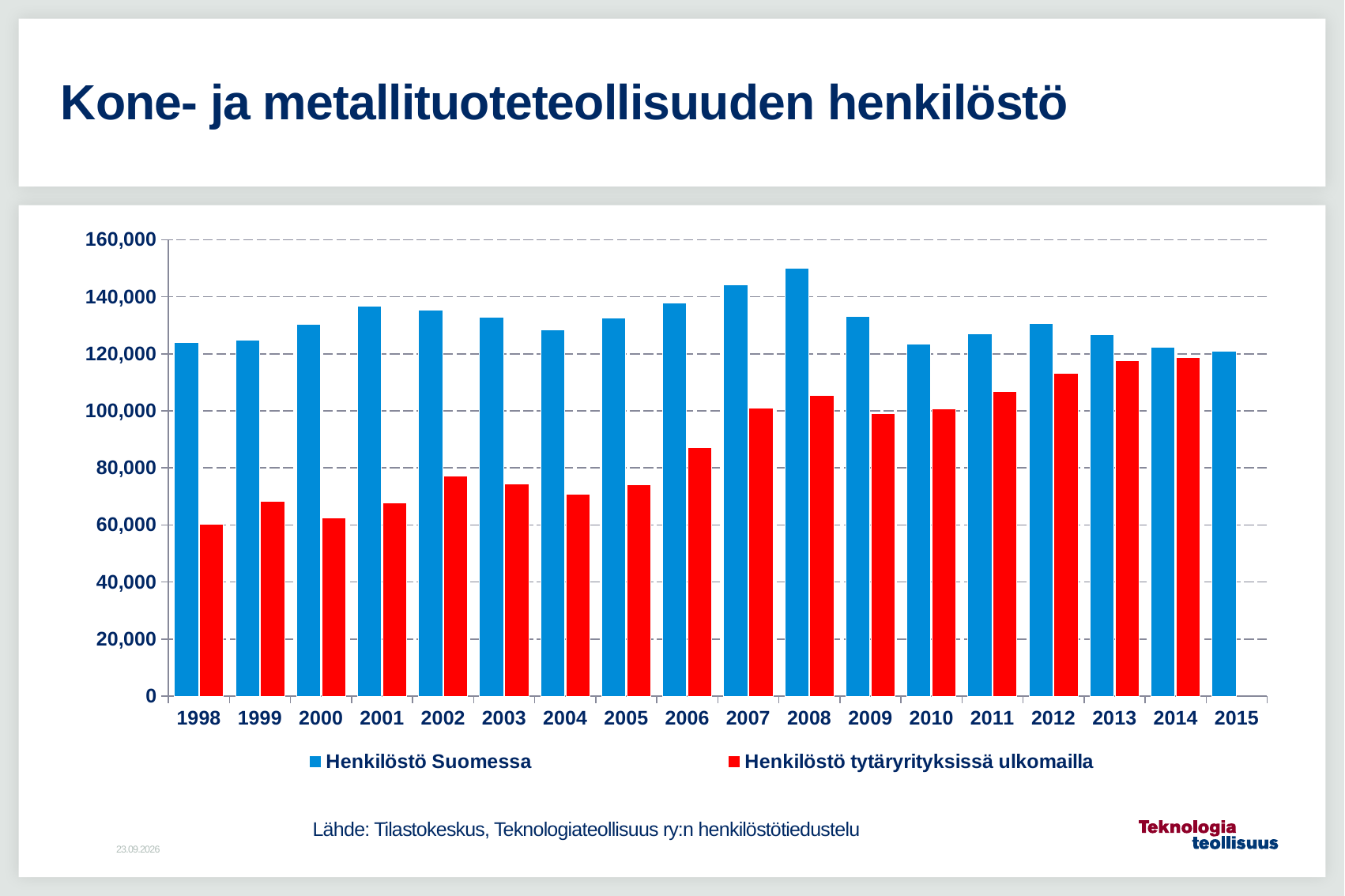
Does the value for Henkilöstö tytäryrityksissä ulkomailla generally rise or fall from 1998 to 2014? rise How many series does the legend list? 2 Is the value for Henkilöstö tytäryrityksissä ulkomailla in 2006 greater or less than 80,000? greater In 2008, which series has the larger value: Henkilöstö Suomessa or Henkilöstö tytäryrityksissä ulkomailla? Henkilöstö Suomessa What kind of chart is shown on the slide? bar chart Is the value for Henkilöstö Suomessa in 2008 greater or less than 140,000? greater Is the value for Henkilöstö tytäryrityksissä ulkomailla in 2002 greater or less than 80,000? less What is the title of the chart on the slide? Kone- ja metallituoteteollisuuden henkilöstö In which year is the value for Henkilöstö Suomessa highest? 2008 How many years are shown on the x axis? 18